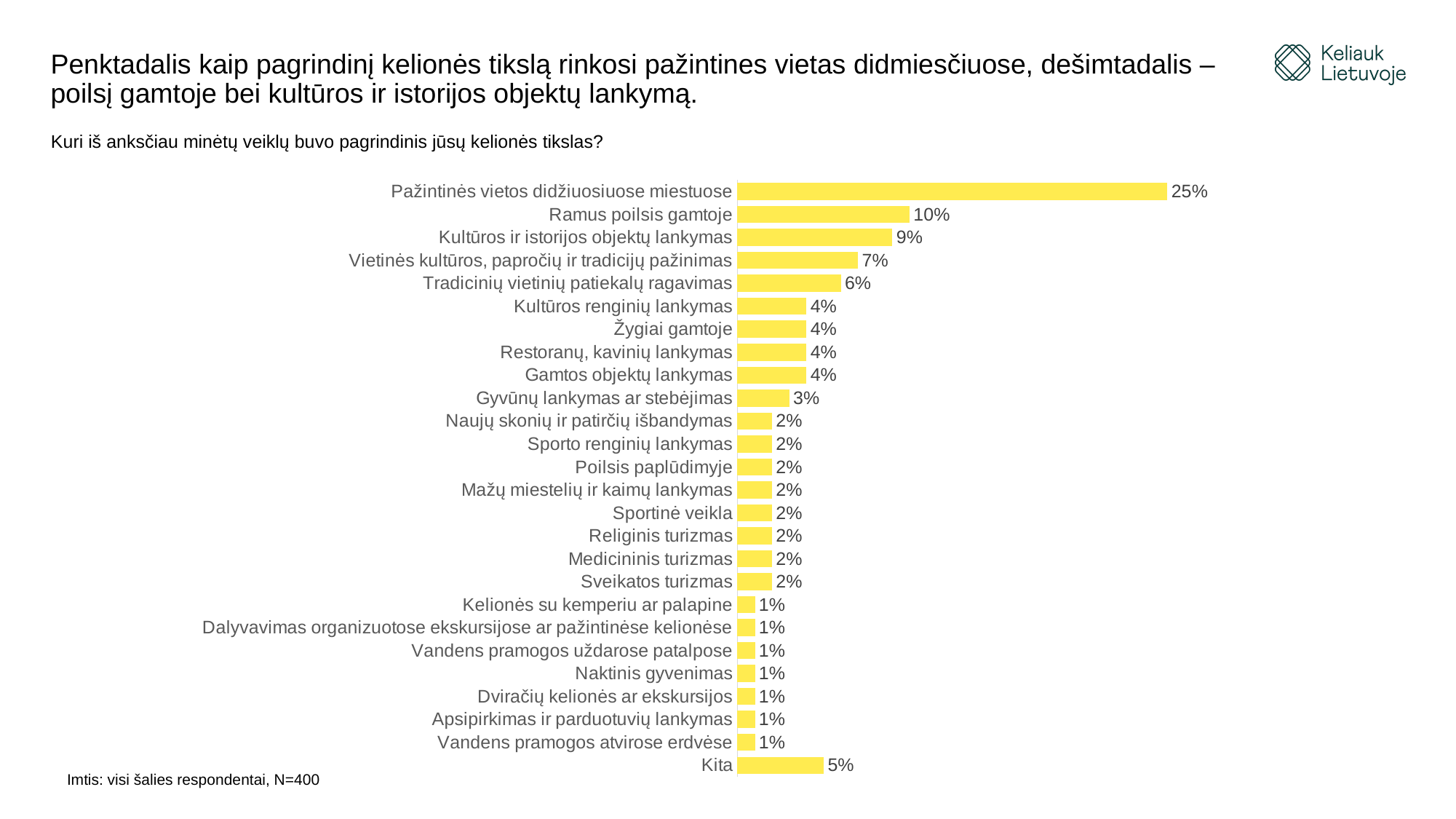
Which category has the highest value in the chart? Pažintinės vietos didžiuosiuose miestuose How many categories are shown in the chart? 26 What is the value shown for "Gyvūnų lankymas ar stebėjimas"? 3% What is the difference between the values for "Vietinės kultūros, papročių ir tradicijų pažinimas" and "Tradicinių vietinių patiekalų ragavimas"? 1% What is the sample size stated at the bottom of the slide? N=400 What percentage of respondents chose "Pažintinės vietos didžiuosiuose miestuose" as their main travel purpose? 25% Which is larger: the value for "Kita" or the value for "Kultūros renginių lankymas"? Kita What type of chart is shown on the slide? Bar chart What is the value shown for "Ramus poilsis gamtoje"? 10% What is the value shown for "Kita"? 5% What is the difference between the values for "Pažintinės vietos didžiuosiuose miestuose" and "Ramus poilsis gamtoje"? 15% What is the value shown for "Kultūros ir istorijos objektų lankymas"? 9%